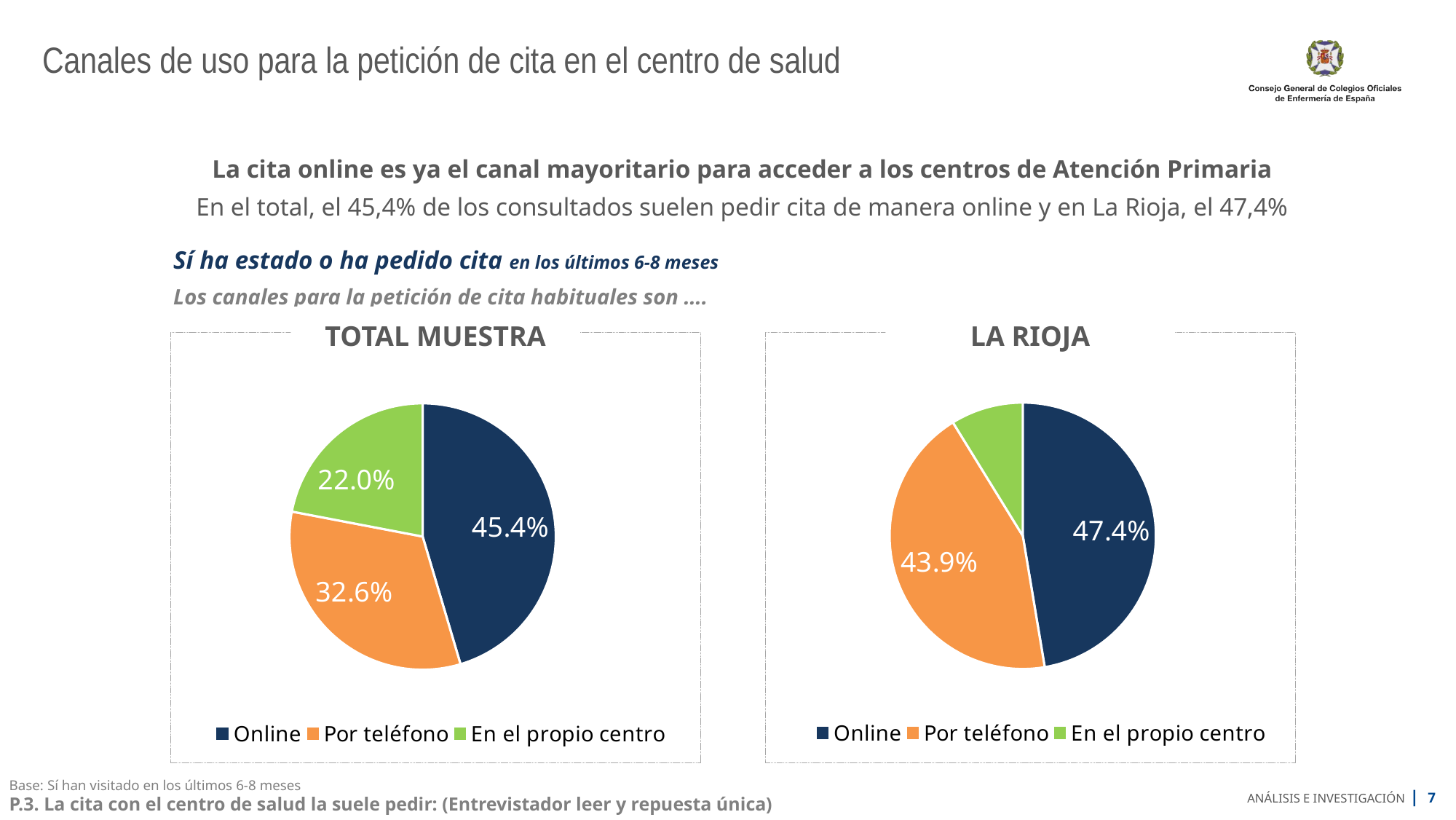
In the TOTAL MUESTRA chart, what is the value for Por teléfono? 32.6% In the TOTAL MUESTRA chart, which channel has the largest share? Online In the LA RIOJA chart, what is the value for Online? 47.4% In the TOTAL MUESTRA chart, what is the value for En el propio centro? 22.0% How many slices does the TOTAL MUESTRA pie chart have? 3 What type of chart is used for LA RIOJA? Pie chart In the LA RIOJA chart, which channel has the smallest share? En el propio centro In the TOTAL MUESTRA chart, what share of respondents request appointments online? 45.4% In the LA RIOJA chart, what is the value for Por teléfono? 43.9% In the TOTAL MUESTRA chart, what is the difference between the Online and Por teléfono shares? 12.8 percentage points In the LA RIOJA chart, what is the difference between the Online and Por teléfono shares? 3.5 percentage points Is the Online share larger in the TOTAL MUESTRA chart or in the LA RIOJA chart? LA RIOJA